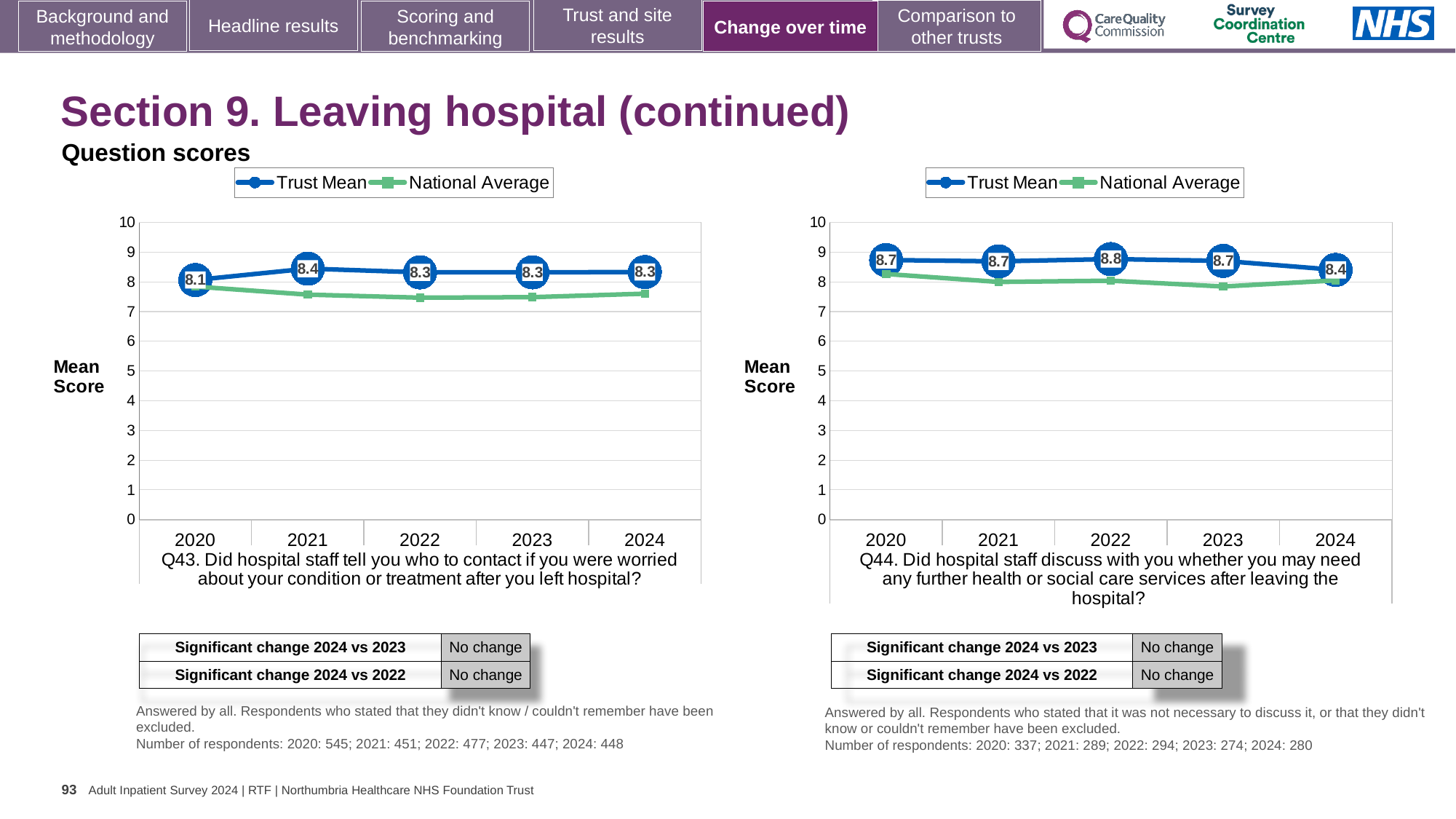
In the Q43 chart on the left, what is the Trust Mean score for 2021? 8.4 In the Q44 chart on the right, is the National Average value for 2023 greater or less than 8? less How many series does the legend of the Q44 chart on the right list? 2 In the Q44 chart on the right, which year has the highest Trust Mean score? 2022 What type of chart is used for Q43 on the left? line chart In the Q43 chart on the left, which year has the lowest Trust Mean score? 2020 How many years are plotted on the x axis of the Q43 chart on the left? 5 In the Q44 chart on the right, what is the Trust Mean score for 2024? 8.4 In the Q44 chart on the right, what is the difference between the Trust Mean score in 2022 and in 2024? 0.4 In the Q43 chart on the left, is the Trust Mean score for 2021 higher or lower than for 2020? higher In the Q44 chart on the right, does the Trust Mean score rise or fall from 2023 to 2024? fall In the Q43 chart on the left, what is the Trust Mean score for 2020? 8.1